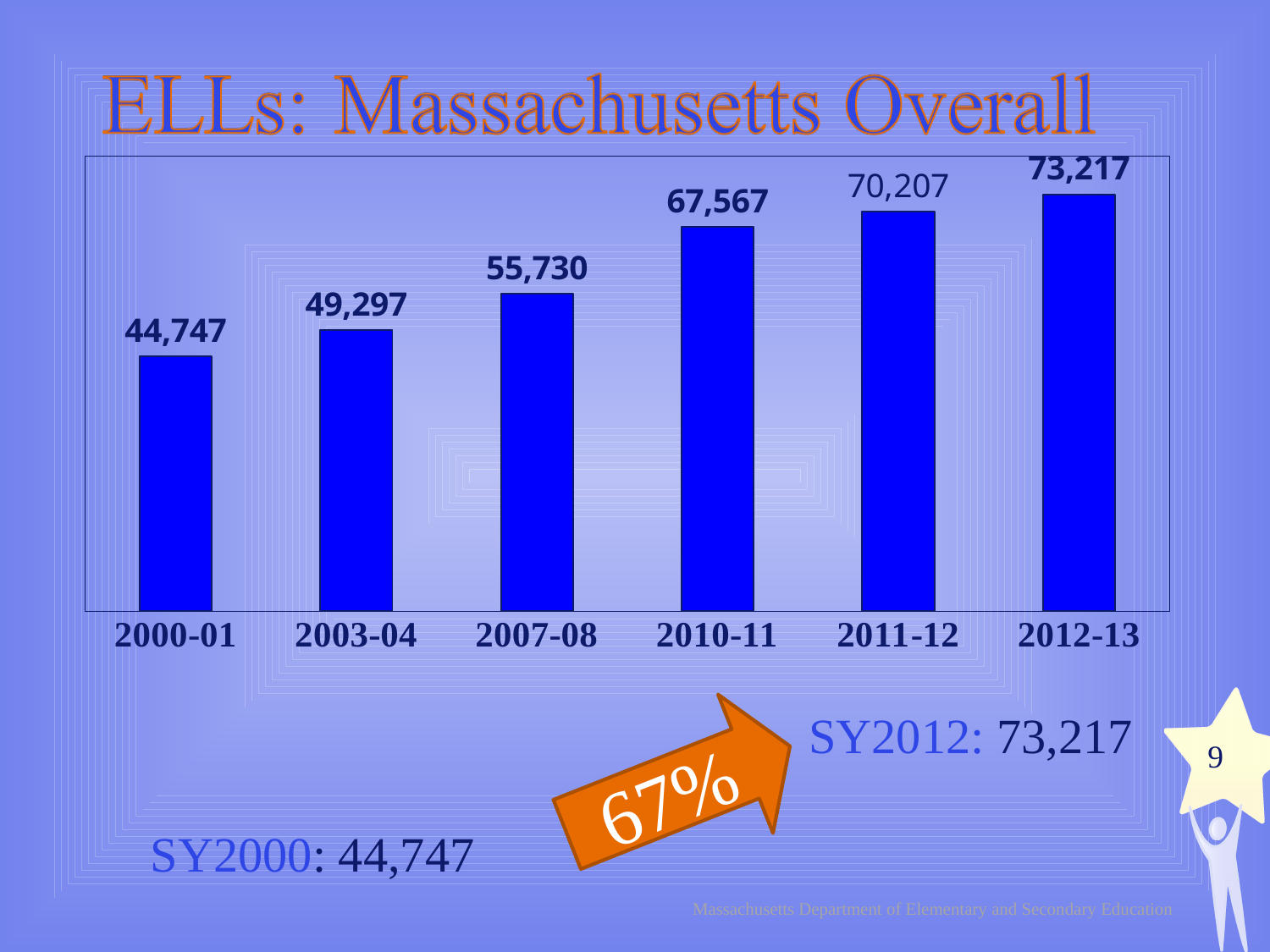
What is the value for 2007-08? 55,730 Which school year has the highest value? 2012-13 What is the value for 2011-12? 70,207 Which school year has the lowest value? 2000-01 What is the value for 2000-01? 44,747 How many school years are shown on the chart? 6 What is the difference between the values for 2010-11 and 2007-08? 11,837 Do the values rise or fall from 2000-01 to 2012-13? Rise What is the title of the slide containing the chart? ELLs: Massachusetts Overall Which is larger, the value for 2003-04 or the value for 2007-08? 2007-08 What is the difference between the values for 2012-13 and 2000-01? 28,470 What kind of chart is shown on the slide? Bar chart